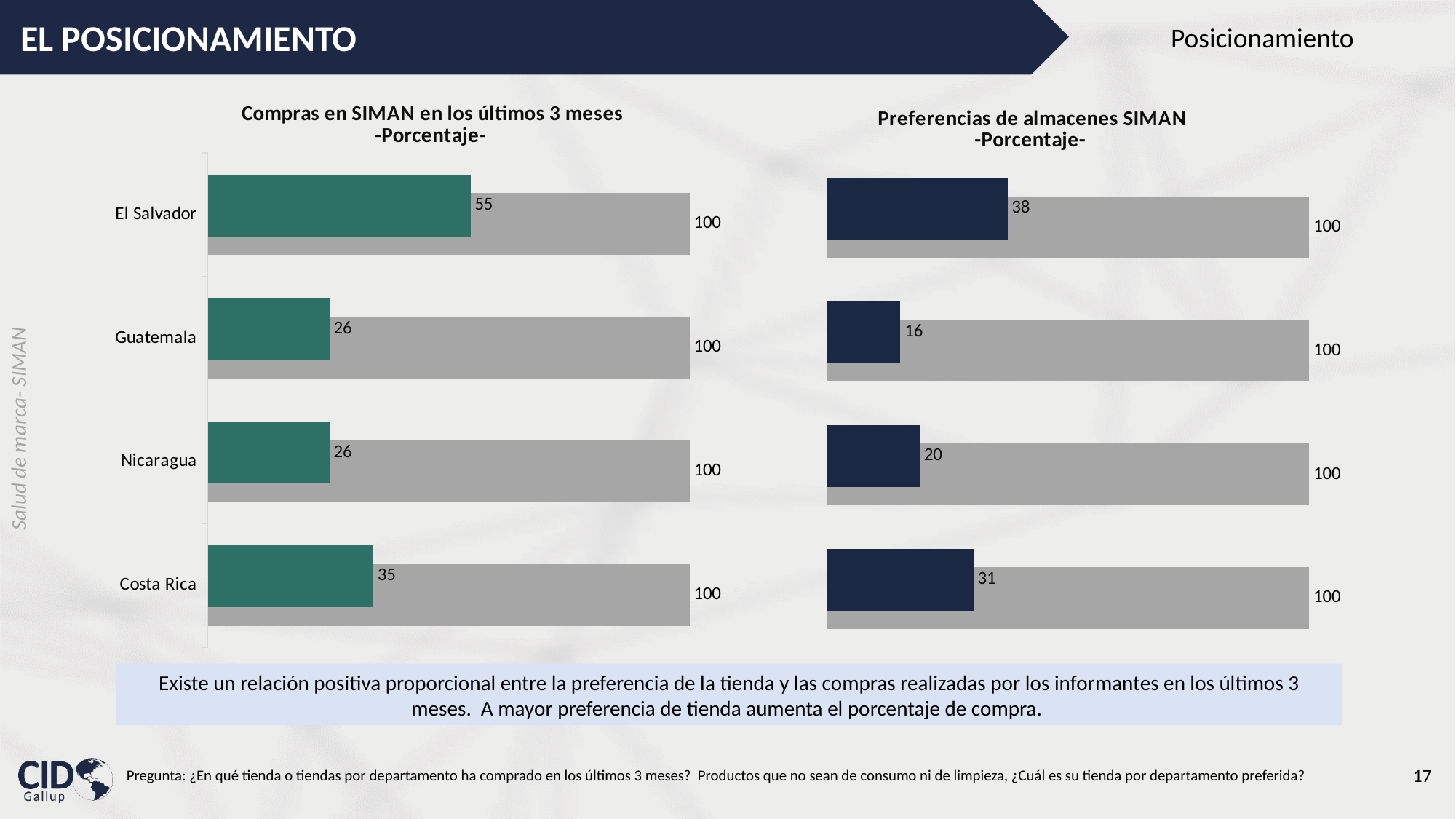
In the chart 'Compras en SIMAN en los últimos 3 meses', which country has the highest value? El Salvador In the chart 'Preferencias de almacenes SIMAN', which is larger, the value for Nicaragua or the value for Guatemala? Nicaragua In the chart 'Preferencias de almacenes SIMAN', which country has the lowest value? Guatemala In the chart 'Preferencias de almacenes SIMAN', what is the value for Costa Rica? 31 In the chart 'Preferencias de almacenes SIMAN', what is the value for Guatemala? 16 In the chart 'Preferencias de almacenes SIMAN', what is the difference between El Salvador and Nicaragua? 18 In the chart 'Compras en SIMAN en los últimos 3 meses', how many countries are shown? 4 What is the title of the chart on the left side of the slide? Compras en SIMAN en los últimos 3 meses -Porcentaje- In the chart 'Compras en SIMAN en los últimos 3 meses', what is the difference between El Salvador and Costa Rica? 20 In the chart 'Compras en SIMAN en los últimos 3 meses', what is the value for Nicaragua? 26 In the chart 'Compras en SIMAN en los últimos 3 meses', what is the value for El Salvador? 55 What type of chart is 'Preferencias de almacenes SIMAN'? Bar chart